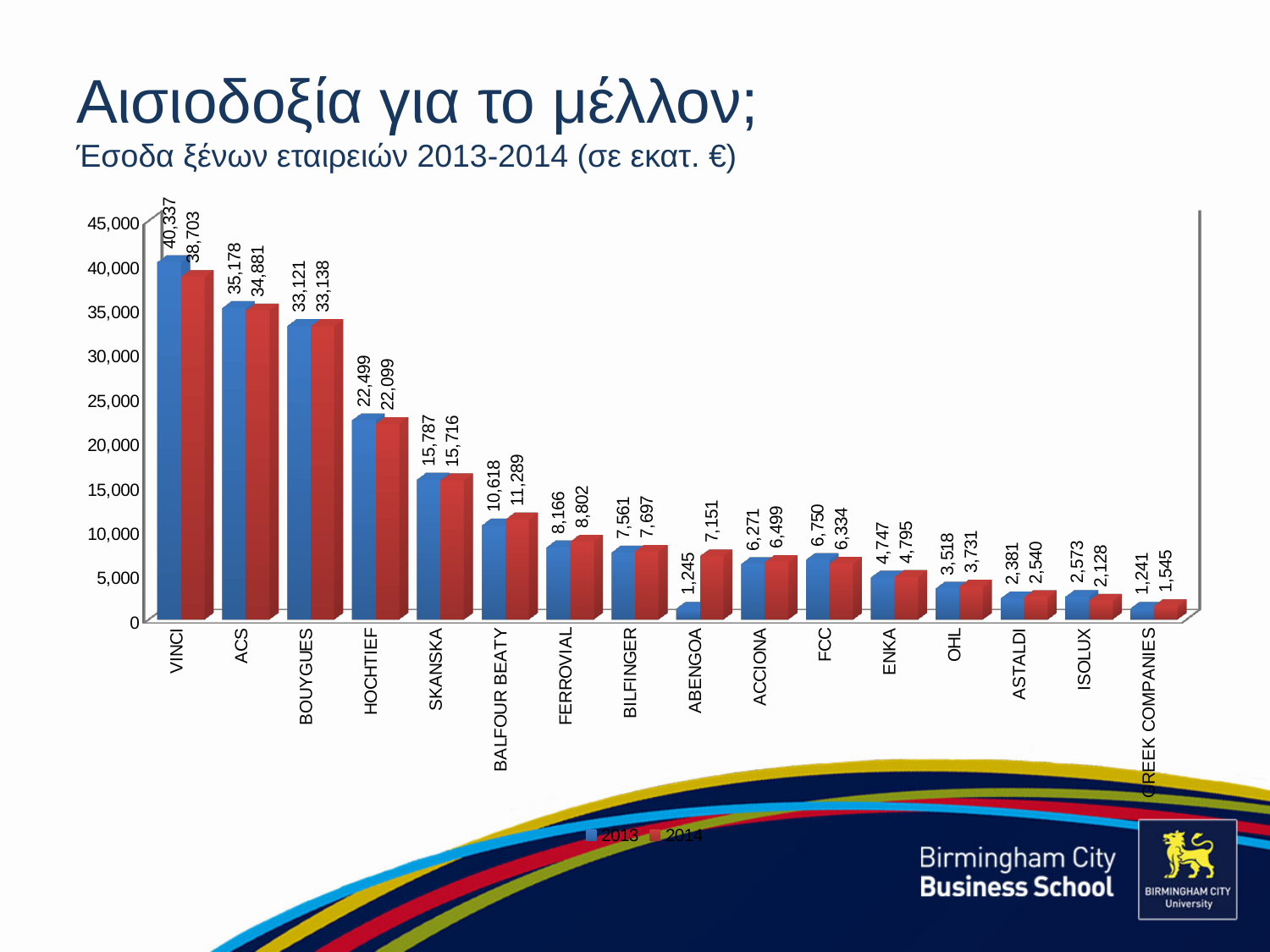
What type of chart is shown on the slide? bar chart How many series does the chart's legend list? 2 What is the difference between the 2014 and 2013 values for ABENGOA? 5,906 Which company has the highest 2014 value? VINCI Which is larger for ISOLUX, the 2013 value or the 2014 value? 2013 What is the 2014 value for HOCHTIEF? 22,099 Which two years are listed in the chart's legend? 2013 and 2014 What is the 2013 value for ABENGOA? 1,245 What is the 2013 value for VINCI? 40,337 What is the difference between the 2013 values of VINCI and ACS? 5,159 Which company has the lowest 2013 value? GREEK COMPANIES How many companies (categories) are shown on the x axis of the chart? 16